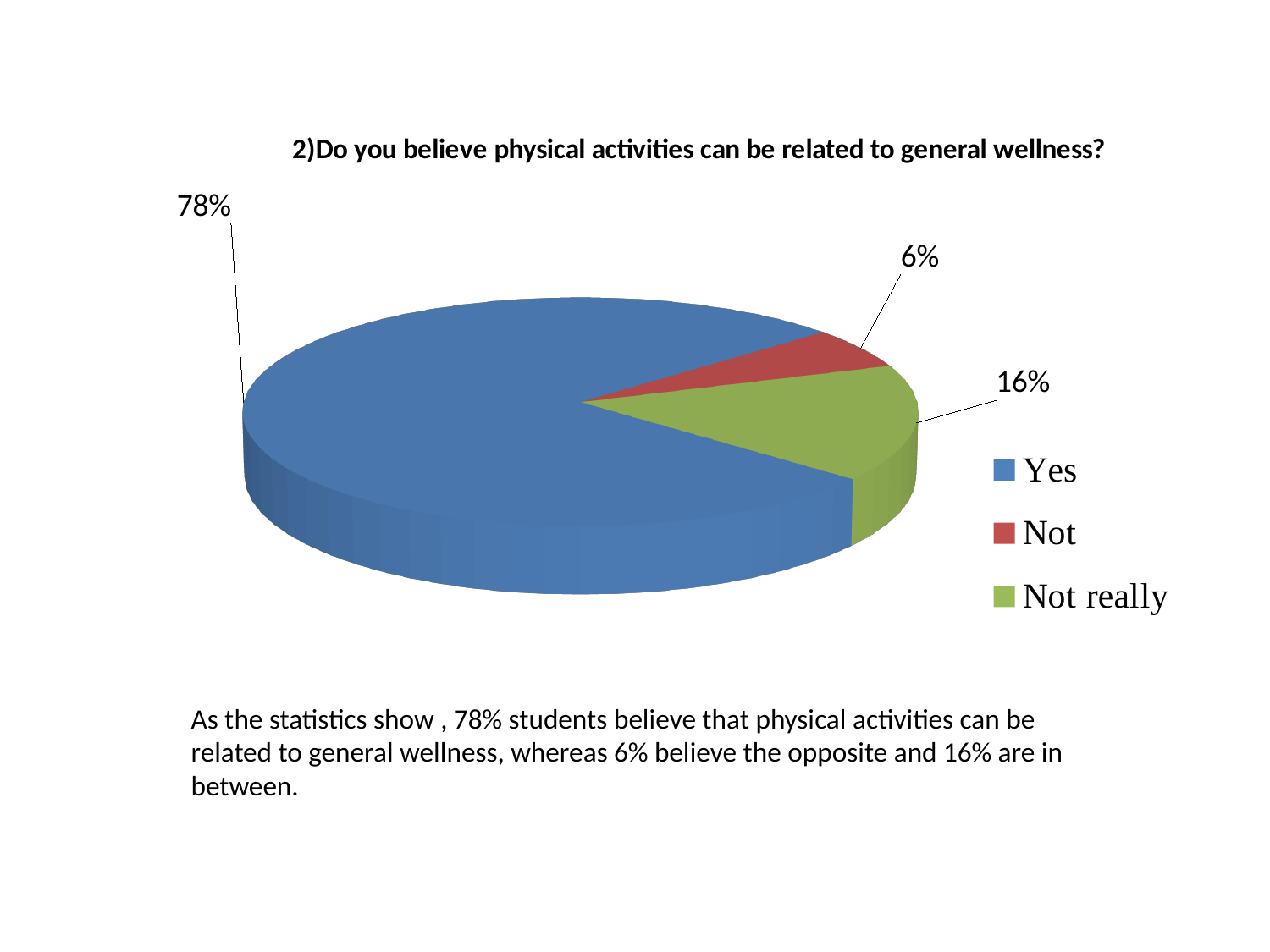
How many slices does the pie chart have? 3 What percentage of students answered "Yes"? 78% Which response has the smallest share of the pie? Not Which response has the largest share of the pie? Yes What is the difference in percentage points between "Yes" and "Not really"? 62 What kind of chart is shown on the slide? pie chart What colour is the "Not really" slice? green What percentage of students answered "Not"? 6% What percentage of students answered "Not really"? 16% Which is larger, the share for "Not really" or the share for "Not"? Not really What is the difference in percentage points between "Not really" and "Not"? 10 How many entries does the legend list? 3